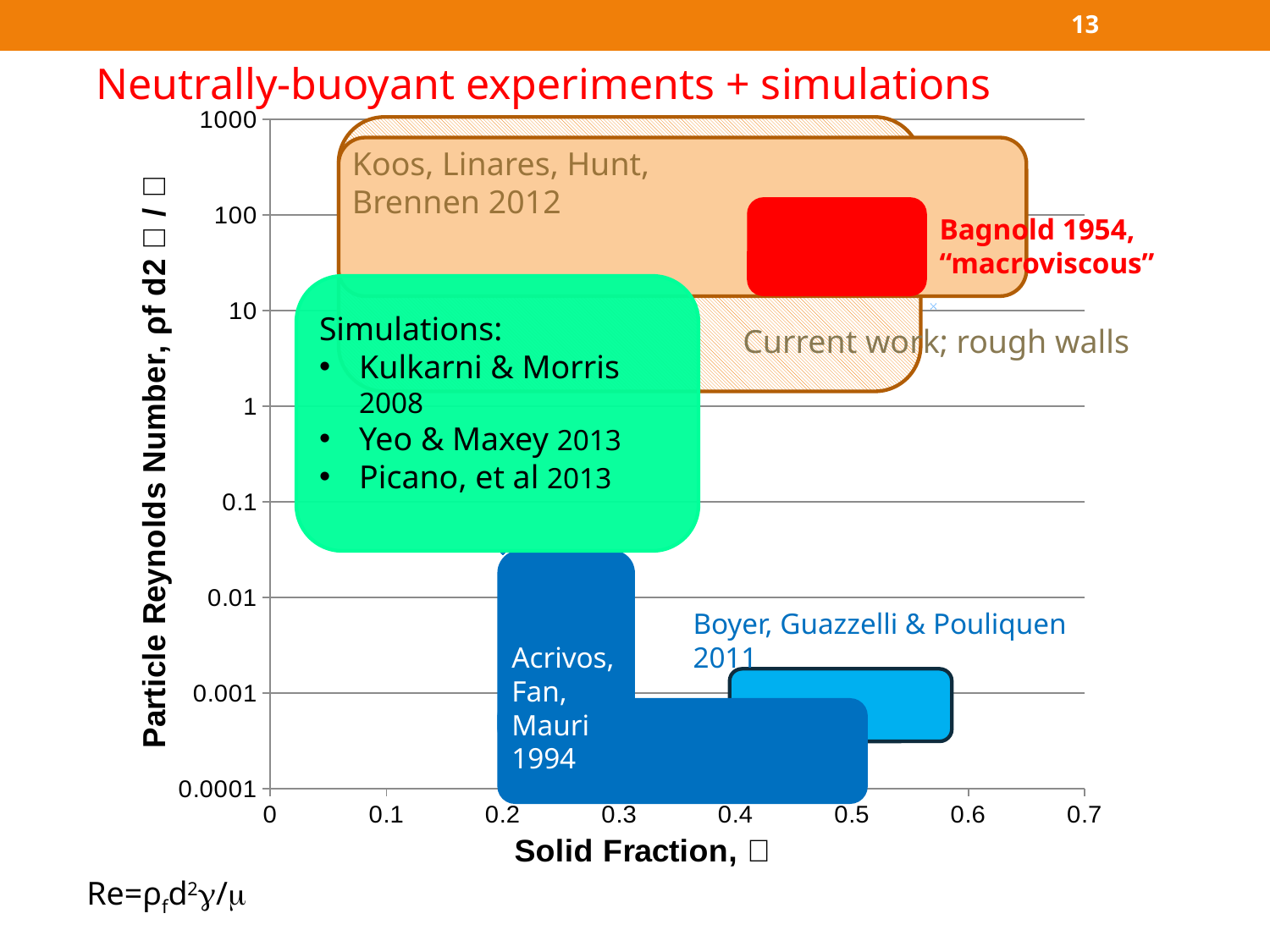
Which region lies at a higher Particle Reynolds Number: Bagnold 1954 or Boyer, Guazzelli & Pouliquen 2011? Bagnold 1954 What is the lowest tick value shown on the y axis (Particle Reynolds Number) of the chart? 0.0001 Is the solid fraction of the Bagnold 1954 region greater or less than 0.3? greater What is the maximum value shown on the x axis of the chart? 0.7 What is the highest tick value shown on the y axis (Particle Reynolds Number) of the chart? 1000 Is the Particle Reynolds Number of the Boyer, Guazzelli & Pouliquen 2011 region greater or less than 0.01? less What is the label of the x axis of the chart? Solid Fraction Which labeled region on the chart reaches the highest Particle Reynolds Number? Current work; rough walls Is the Particle Reynolds Number of the Bagnold 1954 "macroviscous" region greater or less than 10? greater How many tick values are labeled on the x axis of the chart? 8 What is the title of the chart on the slide? Neutrally-buoyant experiments + simulations Which labeled region on the chart reaches the lowest Particle Reynolds Number? Acrivos, Fan, Mauri 1994